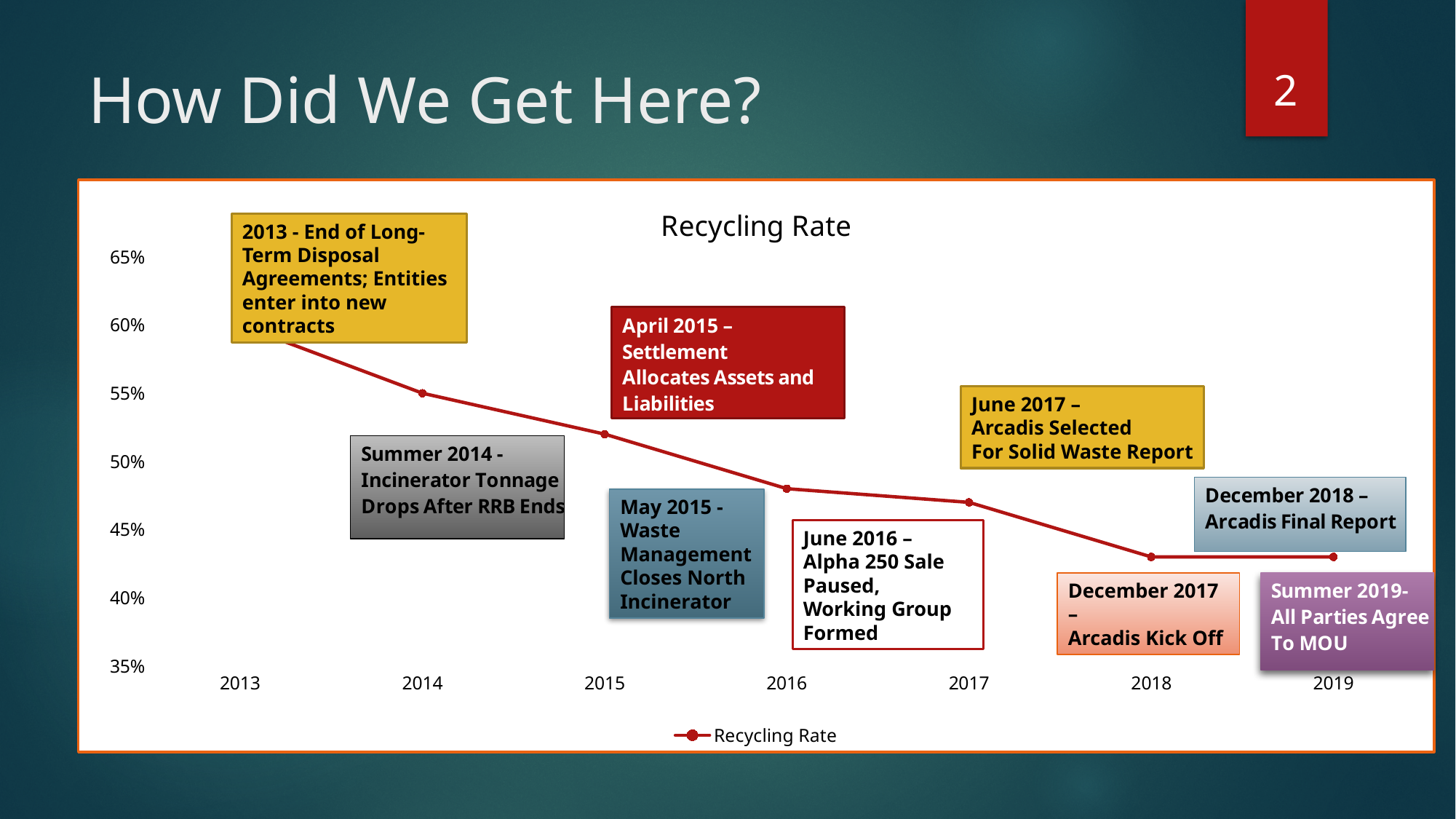
How many series does the legend list? 1 What is the title of the chart? Recycling Rate Is the recycling rate for 2014 greater or less than 50%? greater Which year has the higher recycling rate, 2015 or 2018? 2015 Does the recycling rate rise or fall from 2013 to 2019? fall Is the recycling rate for 2014 greater or less than 60%? less Is the recycling rate for 2016 greater or less than 50%? less What kind of chart is shown on the slide? line chart How many years are shown on the x axis of the chart? 7 Which year has the higher recycling rate, 2014 or 2016? 2014 Which year has the highest recycling rate? 2013